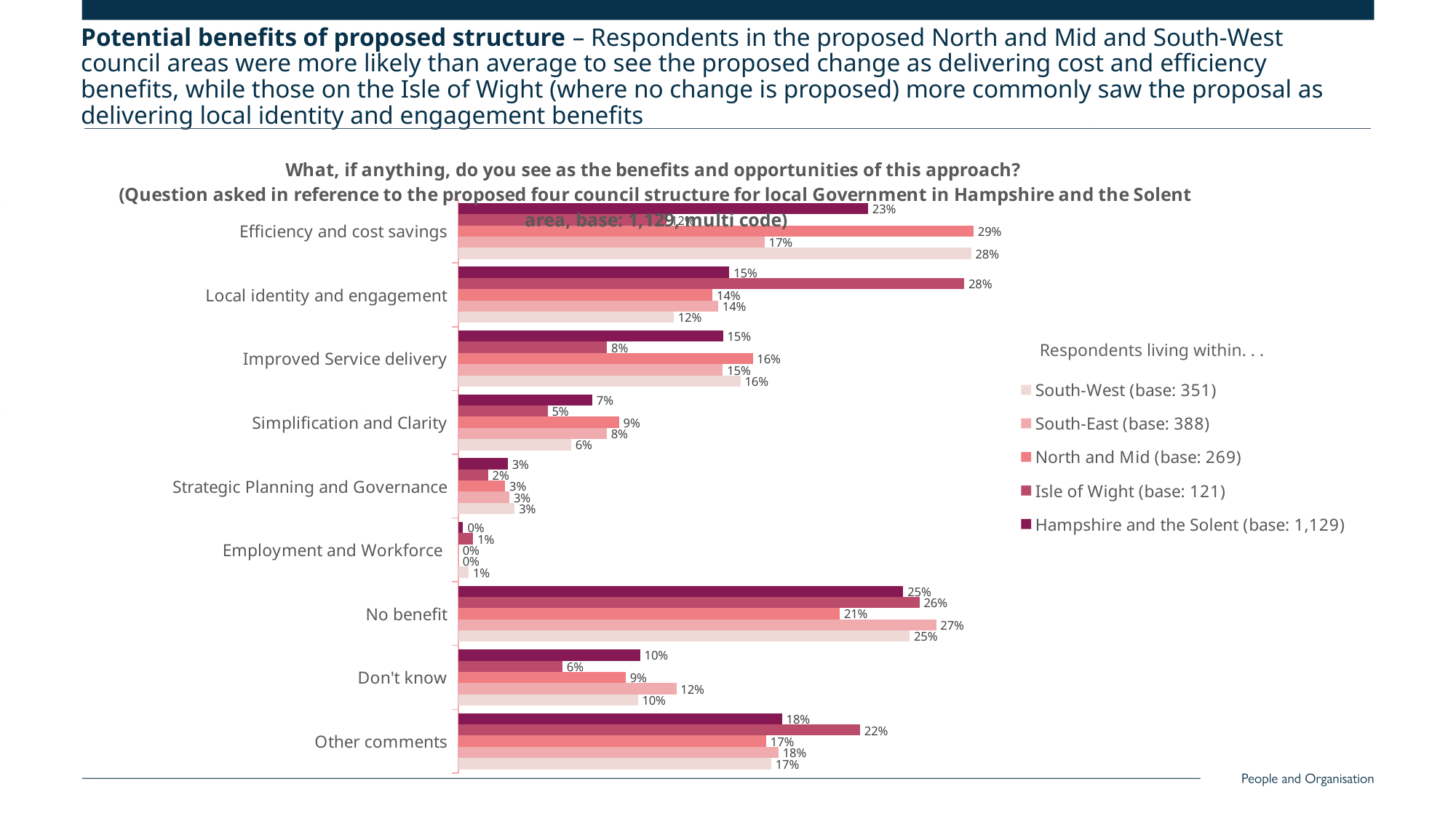
Which category has the highest value for Isle of Wight? Local identity and engagement What is the value for North and Mid for Efficiency and cost savings? 29% What is the value for Hampshire and the Solent for No benefit? 25% What is the value for Isle of Wight for Local identity and engagement? 28% What is the base for the Isle of Wight series shown in the legend? 121 How many series does the legend list? 5 How many categories are shown on the chart? 9 What is the difference between the South-West and South-East values for Efficiency and cost savings? 11% For Don't know, which is larger: the South-East value or the Isle of Wight value? South-East Which category has the lowest value for South-East? Employment and Workforce What kind of chart is shown on the slide? Bar chart What is the value for Isle of Wight for Other comments? 22%